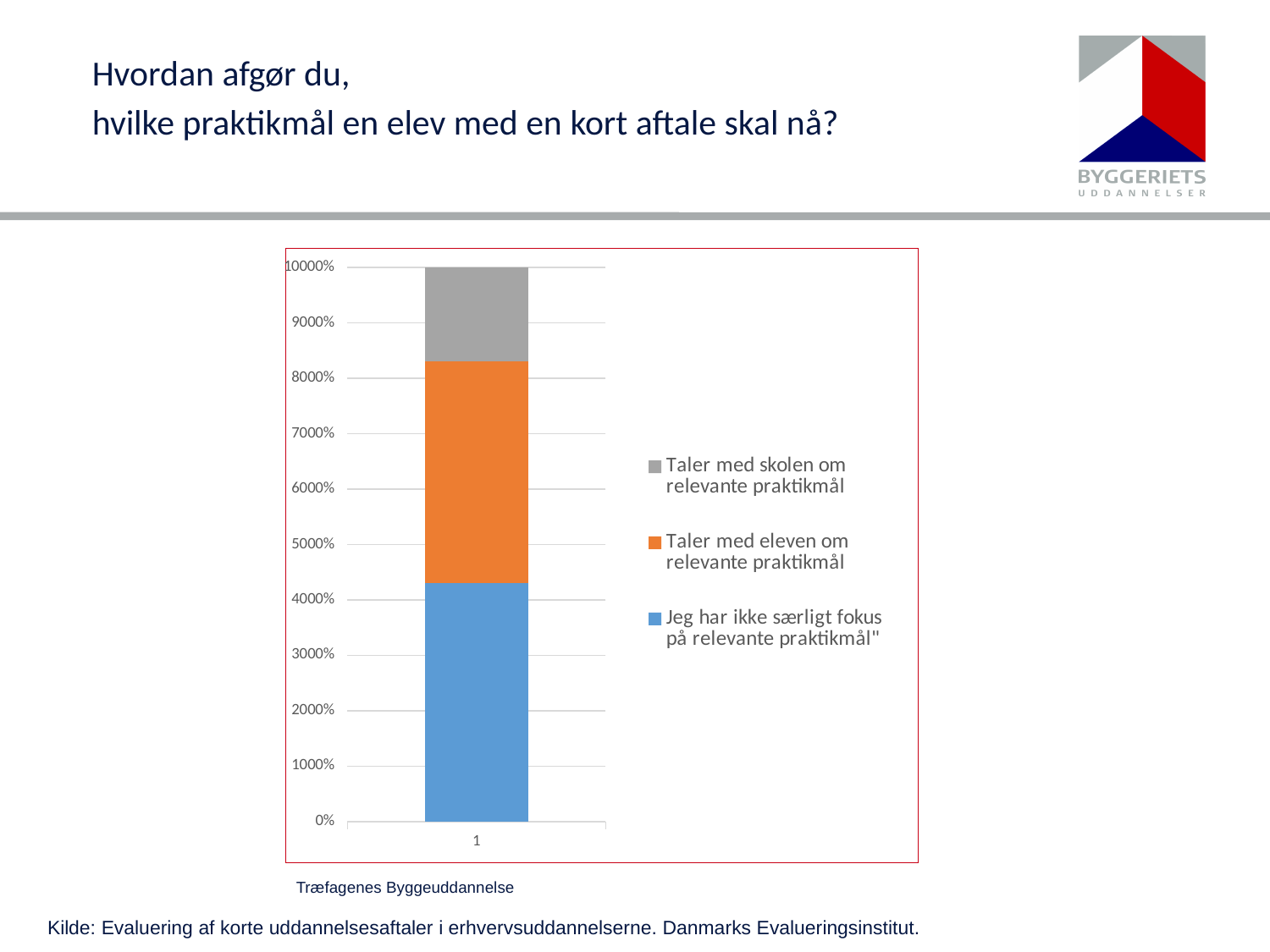
Which segment is larger: 'Taler med eleven om relevante praktikmål' or 'Taler med skolen om relevante praktikmål'? Taler med eleven om relevante praktikmål How many categories are shown on the x axis? 1 How many series does the legend list? 3 Is the value for 'Taler med eleven om relevante praktikmål' greater or less than 3000%? greater Which series is shown in blue in the legend? Jeg har ikke særligt fokus på relevante praktikmål" What is the total height of the stacked bar for category 1? 10000% Is the value for 'Jeg har ikke særligt fokus på relevante praktikmål' greater or less than 4000%? greater Which series is shown in grey in the legend? Taler med skolen om relevante praktikmål Which series has the smallest segment in the stacked bar? Taler med skolen om relevante praktikmål Which segment is larger: 'Jeg har ikke særligt fokus på relevante praktikmål' or 'Taler med skolen om relevante praktikmål'? Jeg har ikke særligt fokus på relevante praktikmål What kind of chart is shown on the slide? stacked bar chart Is the value for 'Taler med skolen om relevante praktikmål' greater or less than 2000%? less